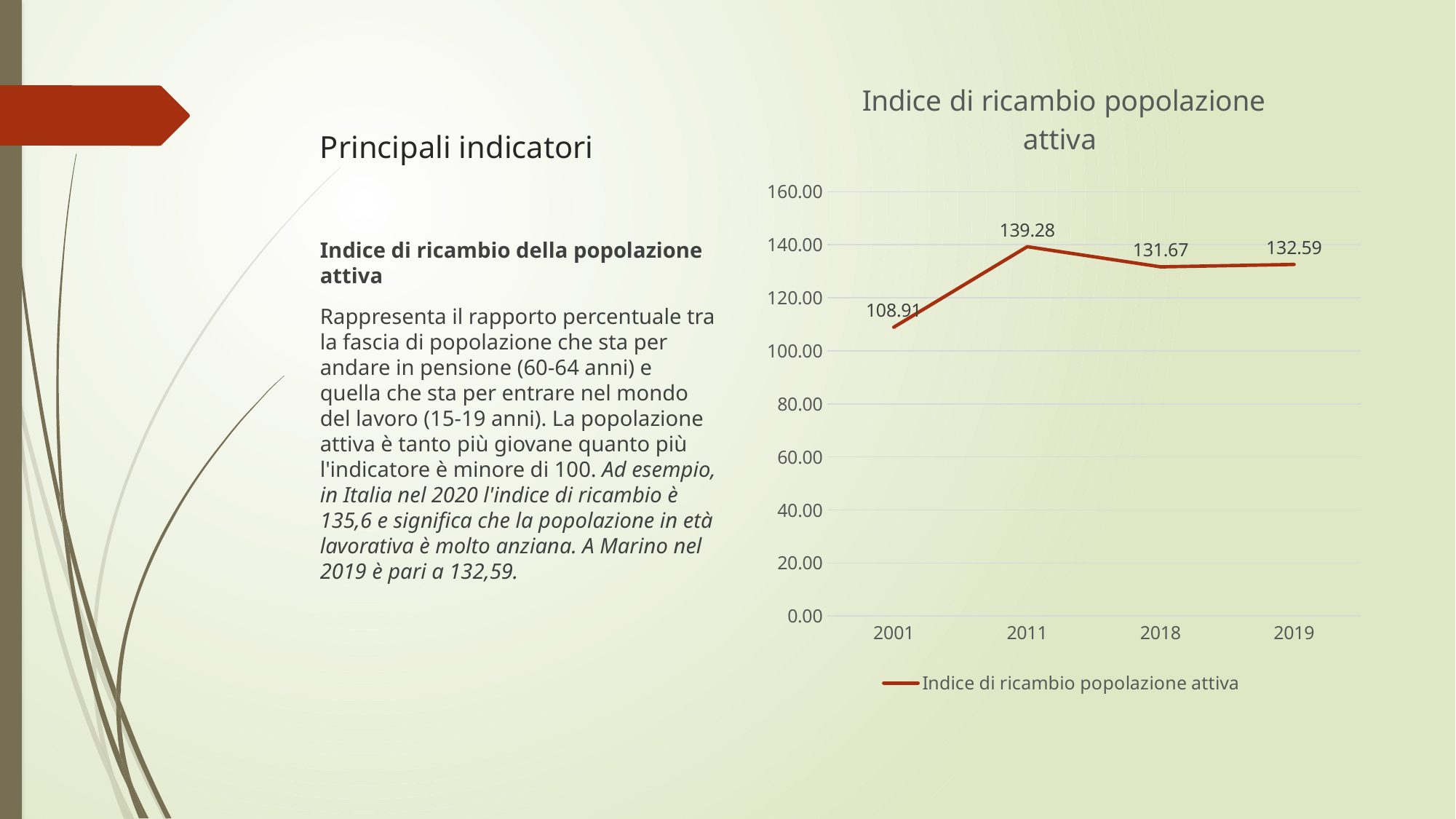
What is the title of the chart? Indice di ricambio popolazione attiva What is the value of the Indice di ricambio popolazione attiva for 2019? 132.59 How many years are plotted on the chart? 4 Is the value for 2001 greater or less than 120? less Which year has the lowest value of the Indice di ricambio popolazione attiva? 2001 What is the value of the Indice di ricambio popolazione attiva for 2018? 131.67 What is the difference between the values for 2011 and 2001? 30.37 What is the value of the Indice di ricambio popolazione attiva for 2011? 139.28 What is the value of the Indice di ricambio popolazione attiva for 2001? 108.91 What kind of chart is shown on the slide? line chart Which year has the highest value of the Indice di ricambio popolazione attiva? 2011 Which year has the larger value, 2018 or 2019? 2019